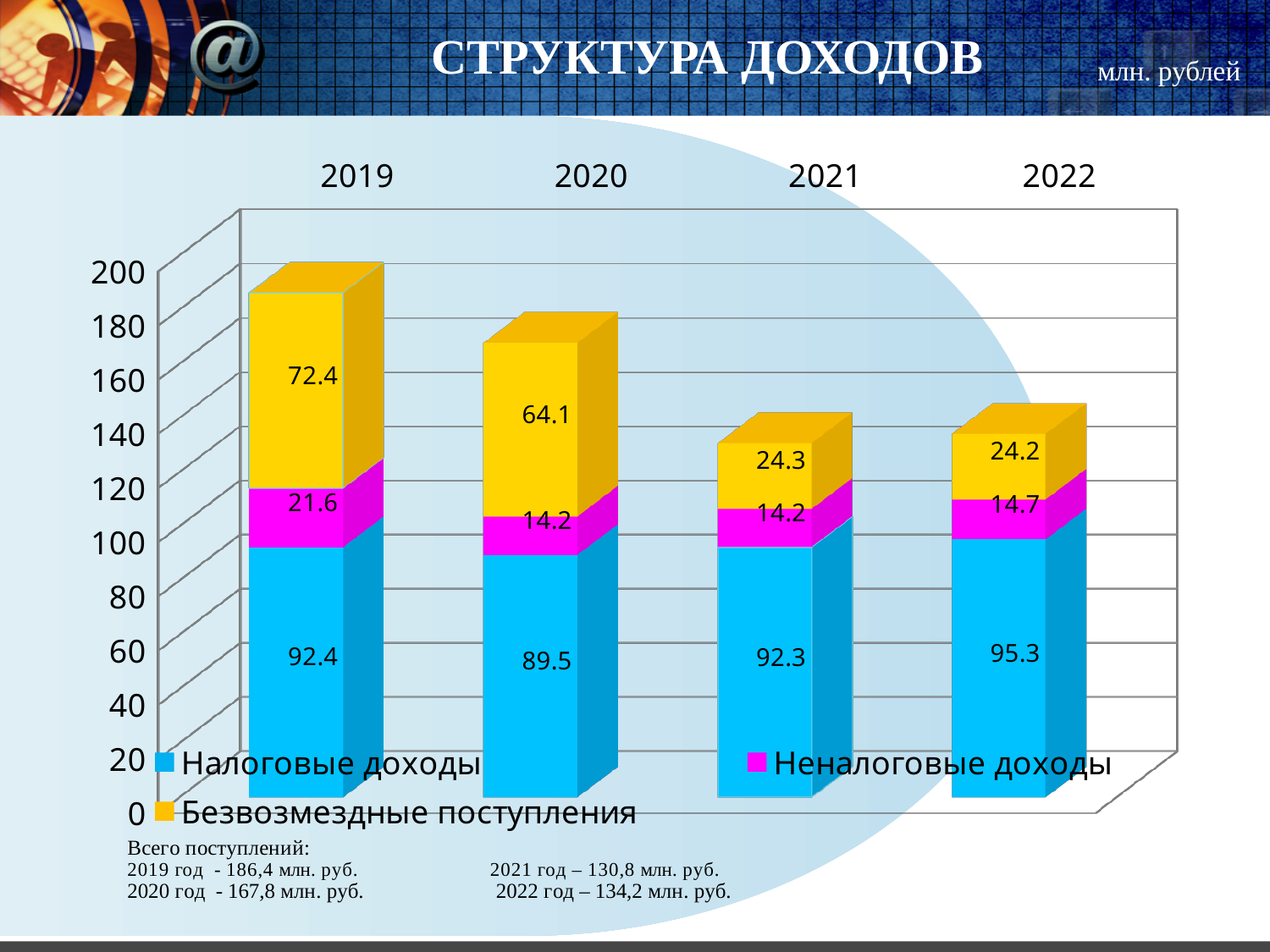
How many series does the legend list? 3 What is the value of Налоговые доходы for 2022? 95.3 How many years are shown on the x axis? 4 Which year has the lowest value for Налоговые доходы? 2020 What is the title of the chart? СТРУКТУРА ДОХОДОВ What is the difference between Безвозмездные поступления in 2019 and in 2020? 8.3 Which year has the highest value for Безвозмездные поступления? 2019 What is the value of Неналоговые доходы for 2020? 14.2 What kind of chart is shown on the slide? Stacked bar chart What is the total of the stacked bar for 2021? 130.8 Which is larger: Неналоговые доходы in 2019 or in 2022? 2019 What is the value of Безвозмездные поступления for 2019? 72.4